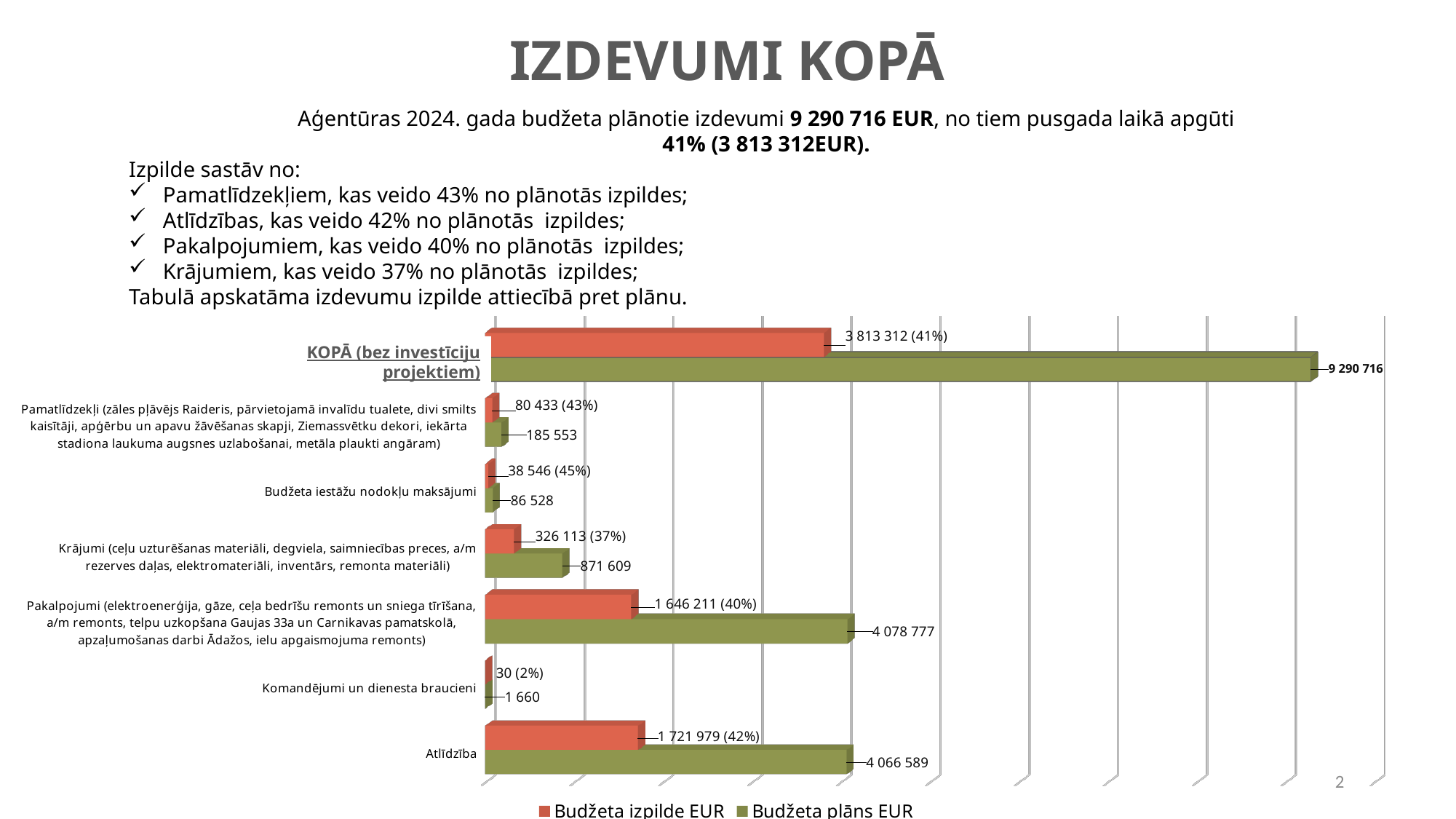
How many categories are shown on the chart? 7 Excluding the KOPĀ total row, which category has the lowest Budžeta plāns EUR value? Komandējumi un dienesta braucieni What is the Budžeta plāns EUR value for KOPĀ (bez investīciju projektiem)? 9 290 716 What is the Budžeta plāns EUR value for Pakalpojumi? 4 078 777 Excluding the KOPĀ total row, which category has the highest Budžeta plāns EUR value? Pakalpojumi What is the Budžeta plāns EUR value for Budžeta iestāžu nodokļu maksājumi? 86 528 How many series does the legend list? 2 What kind of chart is shown on the slide? Bar chart What is the difference between the Budžeta plāns EUR and Budžeta izpilde EUR values for Komandējumi un dienesta braucieni? 1 630 What is the Budžeta izpilde EUR value for Komandējumi un dienesta braucieni? 30 (2%) What is the Budžeta izpilde EUR value for Atlīdzība? 1 721 979 (42%) Which is larger: the Budžeta izpilde EUR value for Atlīdzība or for Pakalpojumi? Atlīdzība